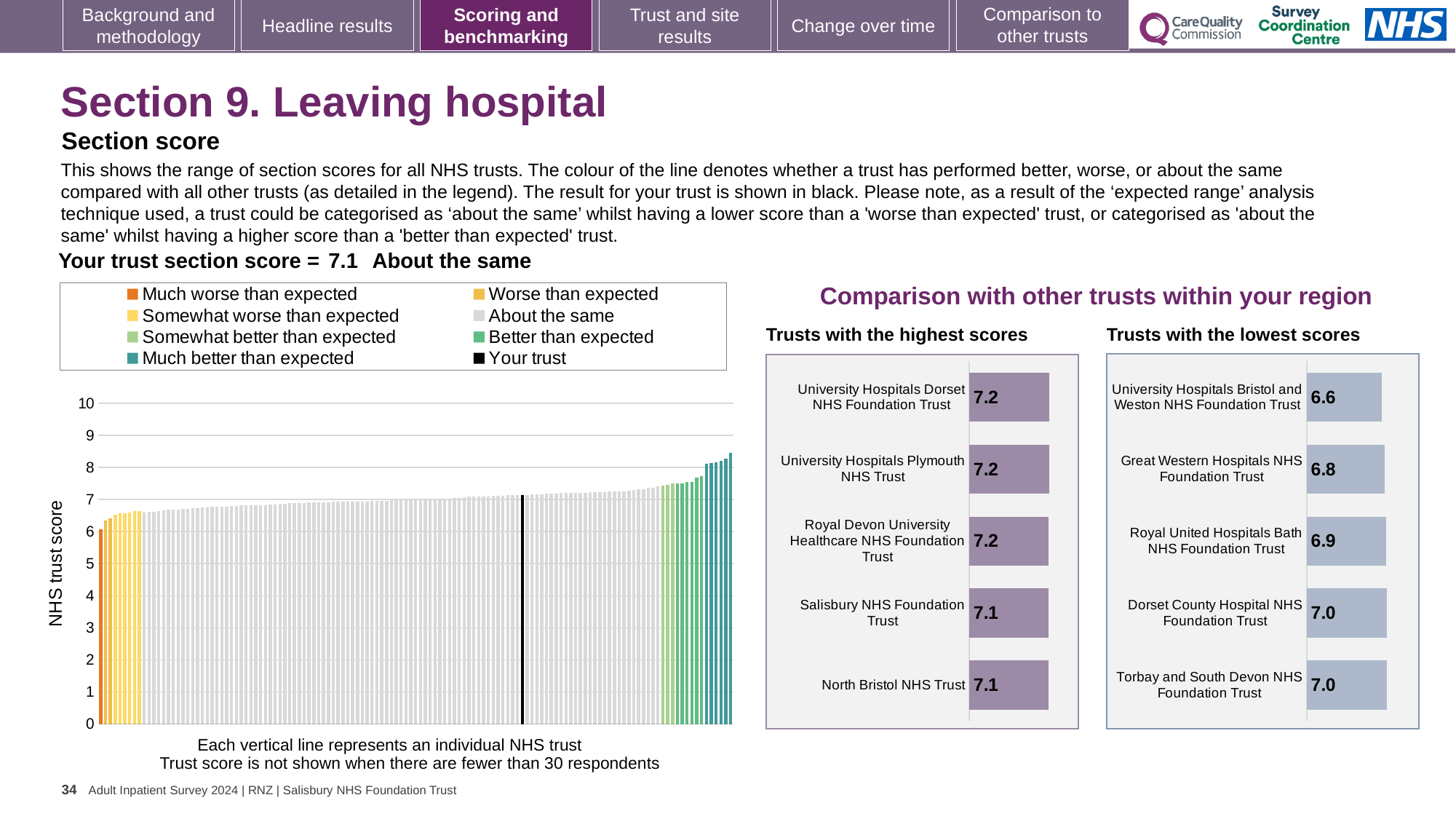
In the 'Trusts with the lowest scores' chart, which trust has the lowest score? University Hospitals Bristol and Weston NHS Foundation Trust What is the section score for your trust shown on the slide? 7.1 How many entries does the legend above the large chart on the left list? 8 How many trusts are shown in the 'Trusts with the highest scores' chart? 5 In the 'Trusts with the highest scores' chart, what is the difference between the scores of University Hospitals Dorset NHS Foundation Trust and North Bristol NHS Trust? 0.1 In the 'Trusts with the lowest scores' chart, what is the difference between the scores of Royal United Hospitals Bath NHS Foundation Trust and University Hospitals Bristol and Weston NHS Foundation Trust? 0.3 In the 'Trusts with the lowest scores' chart, what is the score for Great Western Hospitals NHS Foundation Trust? 6.8 In the 'Trusts with the highest scores' chart, what is the score for Salisbury NHS Foundation Trust? 7.1 What is the label on the vertical axis of the large chart on the left? NHS trust score What kind of chart is the large chart on the left showing NHS trust scores? bar chart In the large chart on the left, do the trust scores rise or fall from left to right? rise In the 'Trusts with the lowest scores' chart, which has the higher score: Great Western Hospitals NHS Foundation Trust or Dorset County Hospital NHS Foundation Trust? Dorset County Hospital NHS Foundation Trust